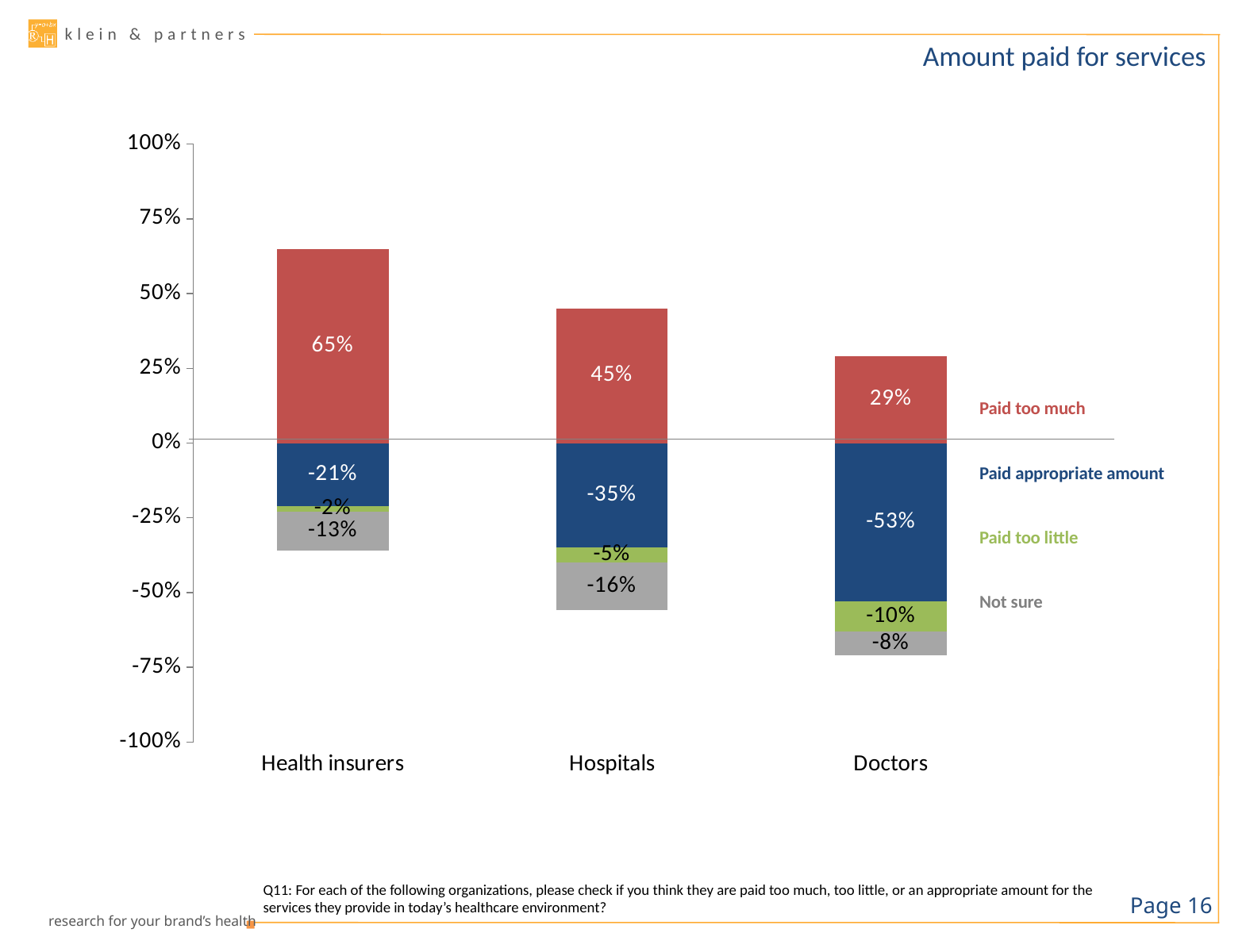
What is the data label for 'Paid appropriate amount' for Doctors? -53% Does the 'Paid too much' percentage rise or fall from Health insurers to Doctors? Fall What is the data label for 'Paid too little' for Health insurers? -2% What type of chart is shown on the slide? Stacked bar chart Which organization has the highest 'Paid too much' percentage? Health insurers Which has a larger 'Paid too much' percentage, Hospitals or Doctors? Hospitals What is the data label for 'Not sure' for Hospitals? -16% How many percentage points higher is the 'Paid too much' value for Health insurers than for Hospitals? 20% Which organization has the lowest 'Paid too much' percentage? Doctors What percentage of respondents think health insurers are paid too much? 65% How many organizations are shown on the x axis? 3 How many response categories does the legend list? 4